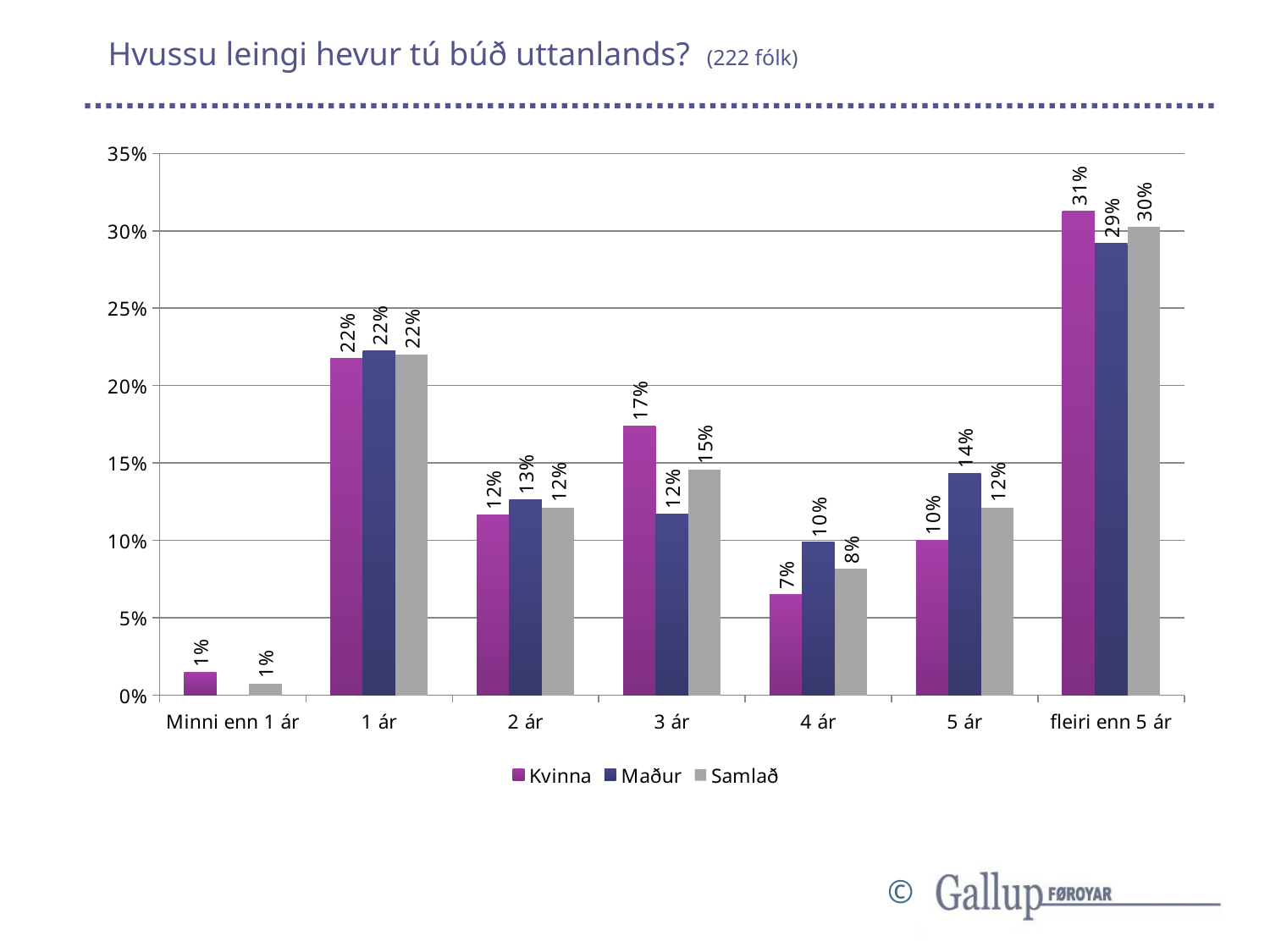
What is the title of the chart? Hvussu leingi hevur tú búð uttanlands? Which category has the lowest Samlað value? Minni enn 1 ár What is the Kvinna value for 3 ár? 17% What is the Samlað value for fleiri enn 5 ár? 30% How many series does the legend list? 3 How many categories are shown on the x axis? 7 What kind of chart is shown on the slide? bar chart For 4 ár, which is larger: the Kvinna value or the Maður value? Maður Is the Maður value for fleiri enn 5 ár greater or less than 25%? greater What is the difference between the Kvinna and Maður values for 3 ár? 5% What is the Maður value for 5 ár? 14% Which category has the highest Kvinna value? fleiri enn 5 ár